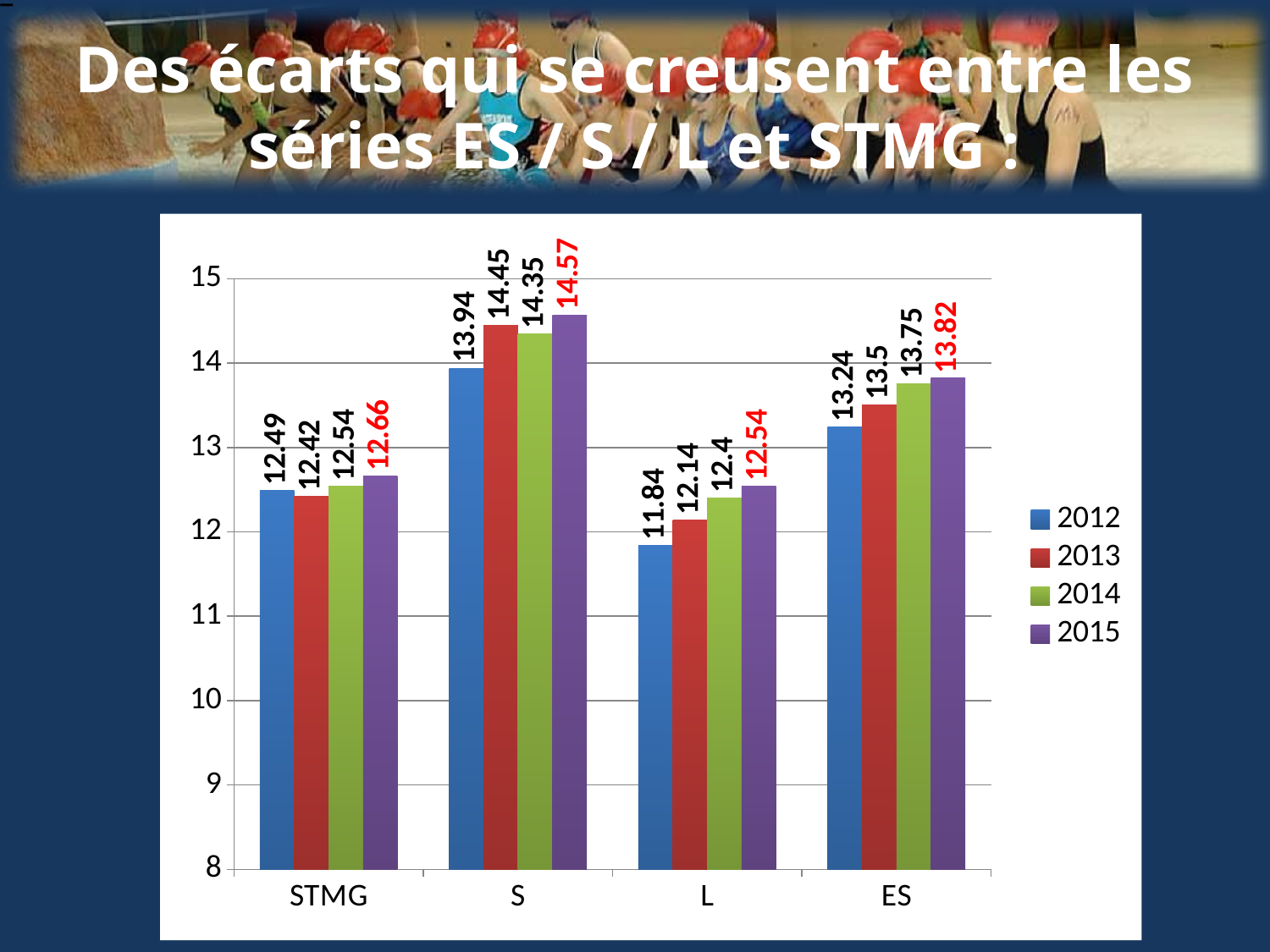
Do the values for ES rise or fall from 2012 to 2015? Rise Which category has the lowest value in 2012? L What kind of chart is shown on the slide? Bar chart How many series does the legend list? 4 What is the difference between the 2015 values for S and L? 2.03 What is the value for STMG in 2013? 12.42 Which is larger, the 2013 value for ES or the 2013 value for STMG? ES What is the value for L in 2012? 11.84 What is the value for ES in 2014? 13.75 What is the value for S in 2015? 14.57 How many categories are shown on the x axis? 4 Which category has the highest value in 2015? S